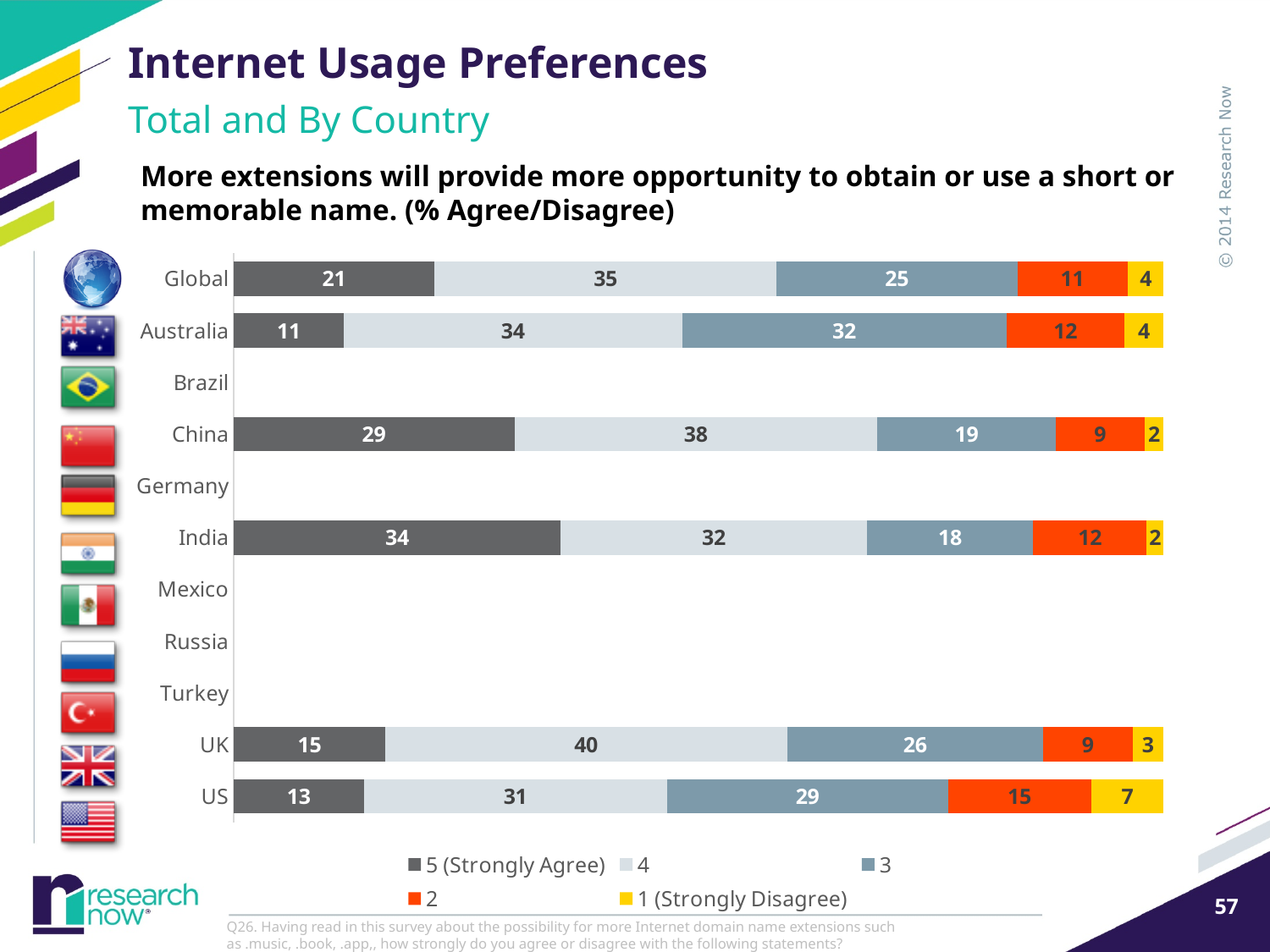
What kind of chart is shown on the slide? Stacked bar chart What is the value for 4 for the UK? 40 Which series is shown in yellow in the legend? 1 (Strongly Disagree) What is the difference between the 5 (Strongly Agree) values for India and Global? 13 What is the total of the stacked bar for China? 97 What is the value for 5 (Strongly Agree) for China? 29 How many series does the legend list? 5 Which is larger, the value for 2 for the US or the value for 2 for the UK? US Which country has the highest value for 5 (Strongly Agree)? India What is the value for 1 (Strongly Disagree) for the US? 7 What is the value for 3 for Australia? 32 Which country has the lowest value for 5 (Strongly Agree)? Australia